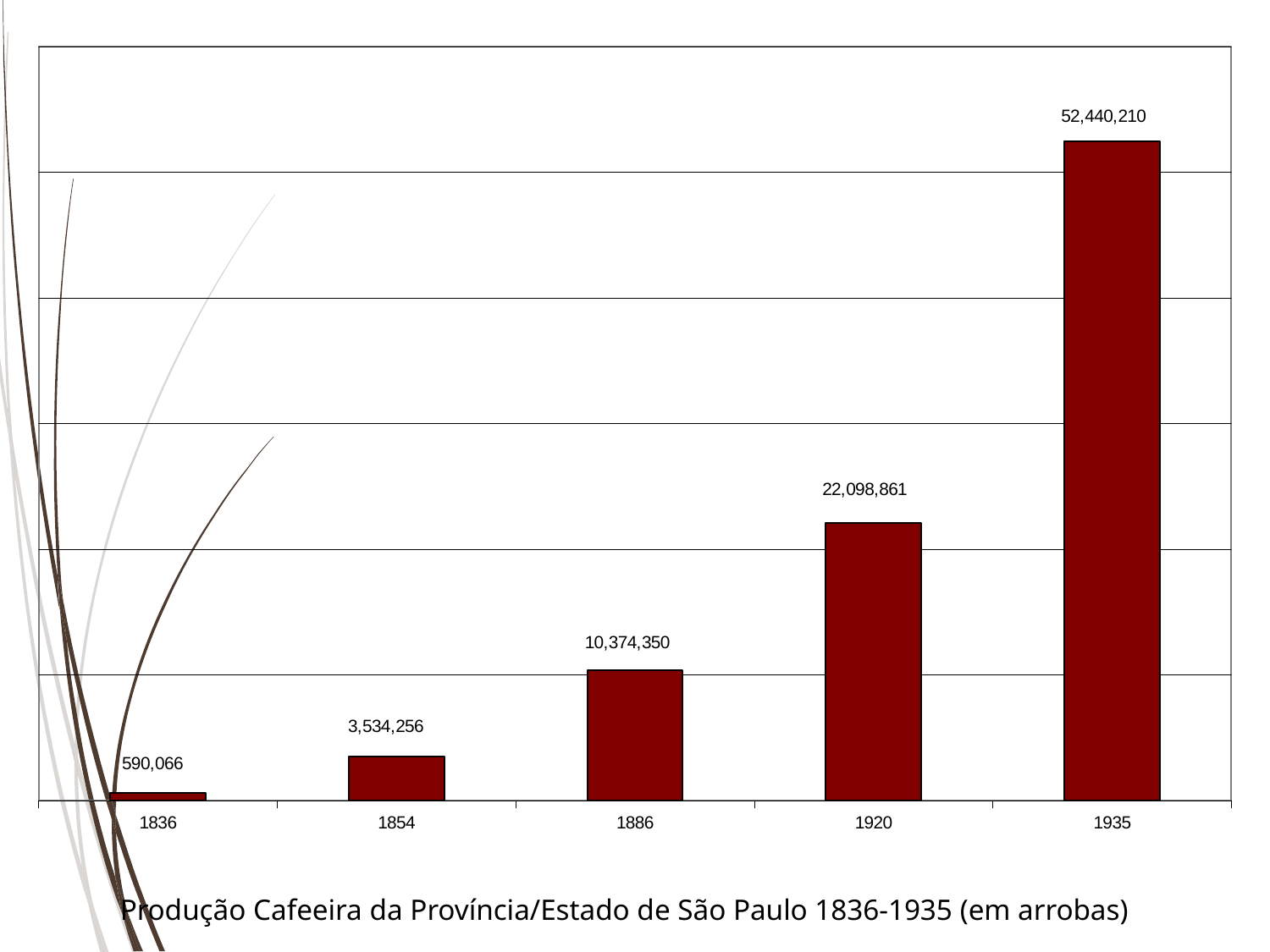
What is the value shown for 1836? 590,066 What is the value shown for 1920? 22,098,861 What is the coffee production value shown for 1935? 52,440,210 What is the difference between the values for 1854 and 1836? 2,944,190 Which year has the lowest coffee production? 1836 What kind of chart is shown on the slide? Bar chart Which year has the highest coffee production? 1935 How many years are shown on the x axis? 5 Which is larger, the value for 1886 or the value for 1854? 1886 What is the value shown for 1886? 10,374,350 What is the difference between the values for 1935 and 1920? 30,341,349 Do the values rise or fall from 1836 to 1935? Rise